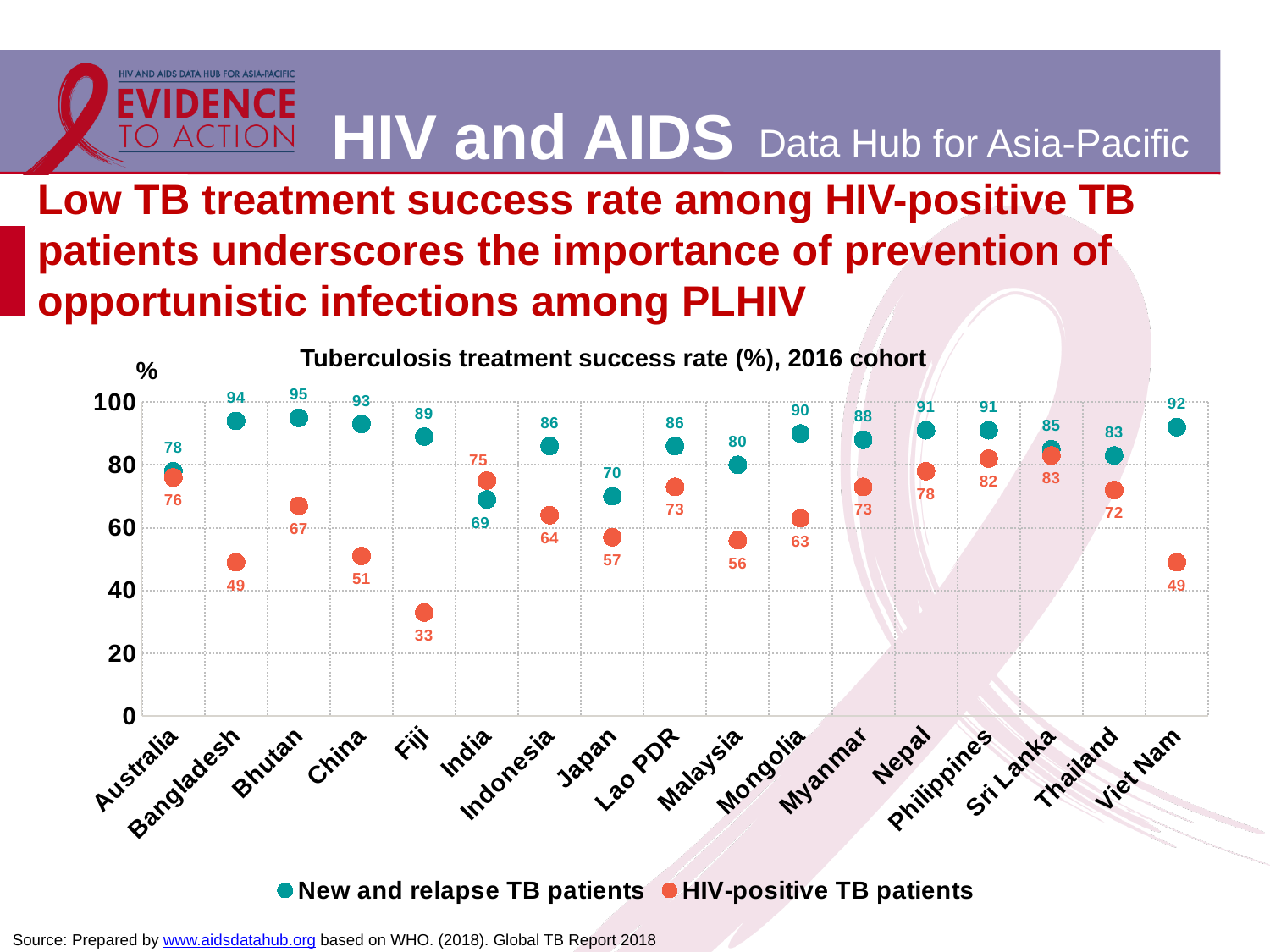
Which country has the lowest treatment success rate among HIV-positive TB patients? Fiji In India, which group has the higher treatment success rate: new and relapse TB patients or HIV-positive TB patients? HIV-positive TB patients What is the difference between the success rates for new and relapse TB patients and HIV-positive TB patients in Bangladesh? 45 How many series does the chart legend list? 2 Which country has the lowest treatment success rate among new and relapse TB patients? India What is the tuberculosis treatment success rate for new and relapse TB patients in Bhutan? 95 What is the tuberculosis treatment success rate for HIV-positive TB patients in Fiji? 33 Which cohort year does the chart title refer to? 2016 cohort What is the tuberculosis treatment success rate for HIV-positive TB patients in Viet Nam? 49 What kind of chart is used to show the tuberculosis treatment success rates? scatter chart How many countries are shown on the x axis of the chart? 17 Which country has the highest treatment success rate among new and relapse TB patients? Bhutan